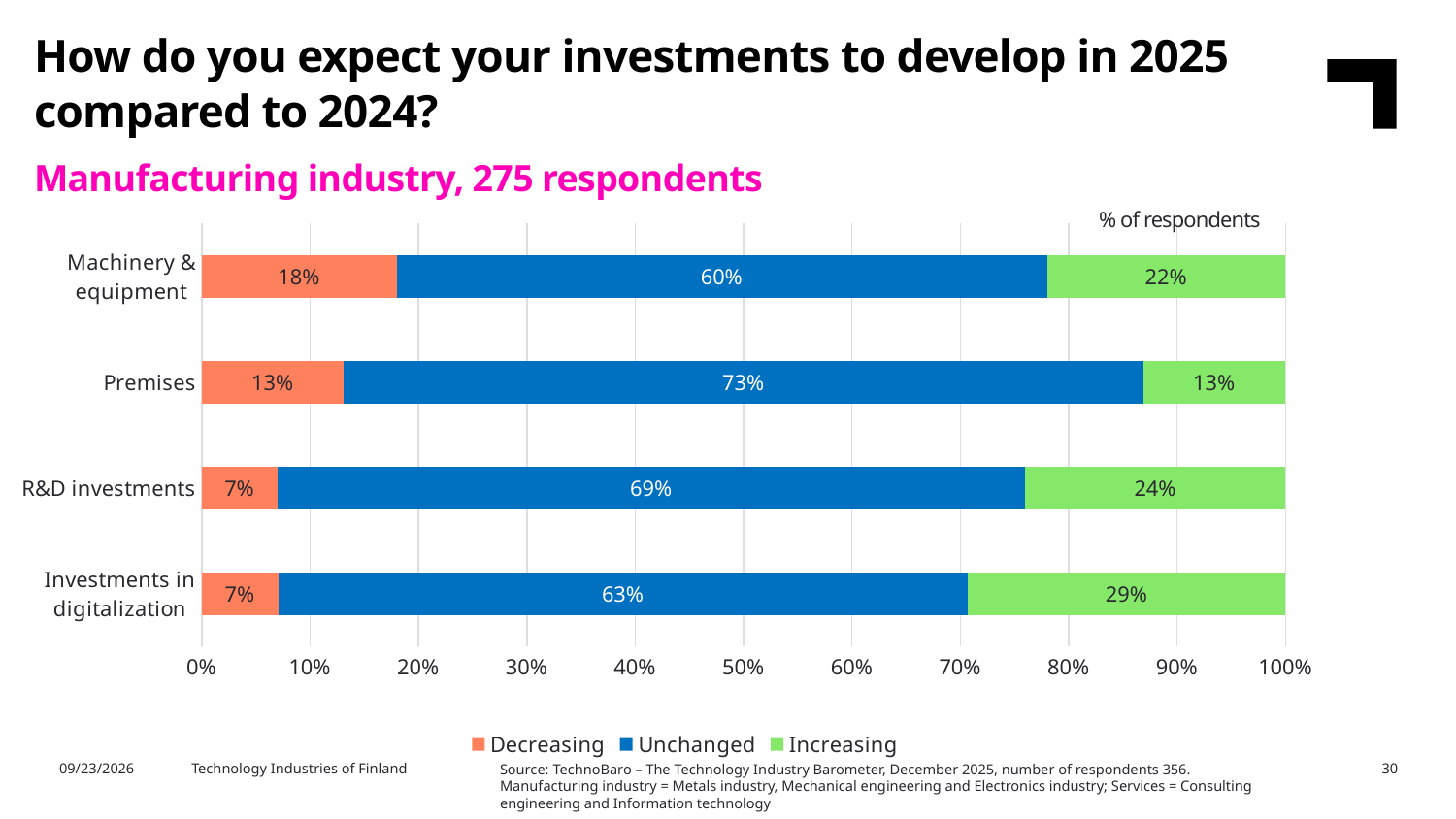
What type of chart is shown on the slide? Stacked bar chart What percentage of respondents expect Investments in digitalization to be Increasing? 29% Which category has the highest share of respondents expecting an increase? Investments in digitalization Which is larger: the Increasing share for R&D investments or for Machinery & equipment? R&D investments What percentage of respondents expect Premises investments to be Decreasing? 13% How many investment categories are shown in the chart? 4 How many series does the legend list? 3 Which category has the lowest Unchanged share? Machinery & equipment What percentage of respondents expect investments in Machinery & equipment to be Unchanged? 60% What is the difference between the Increasing share for Investments in digitalization and for Premises? 16 percentage points What percentage of respondents expect R&D investments to be Unchanged? 69% Which category has the highest share of respondents expecting a decrease? Machinery & equipment